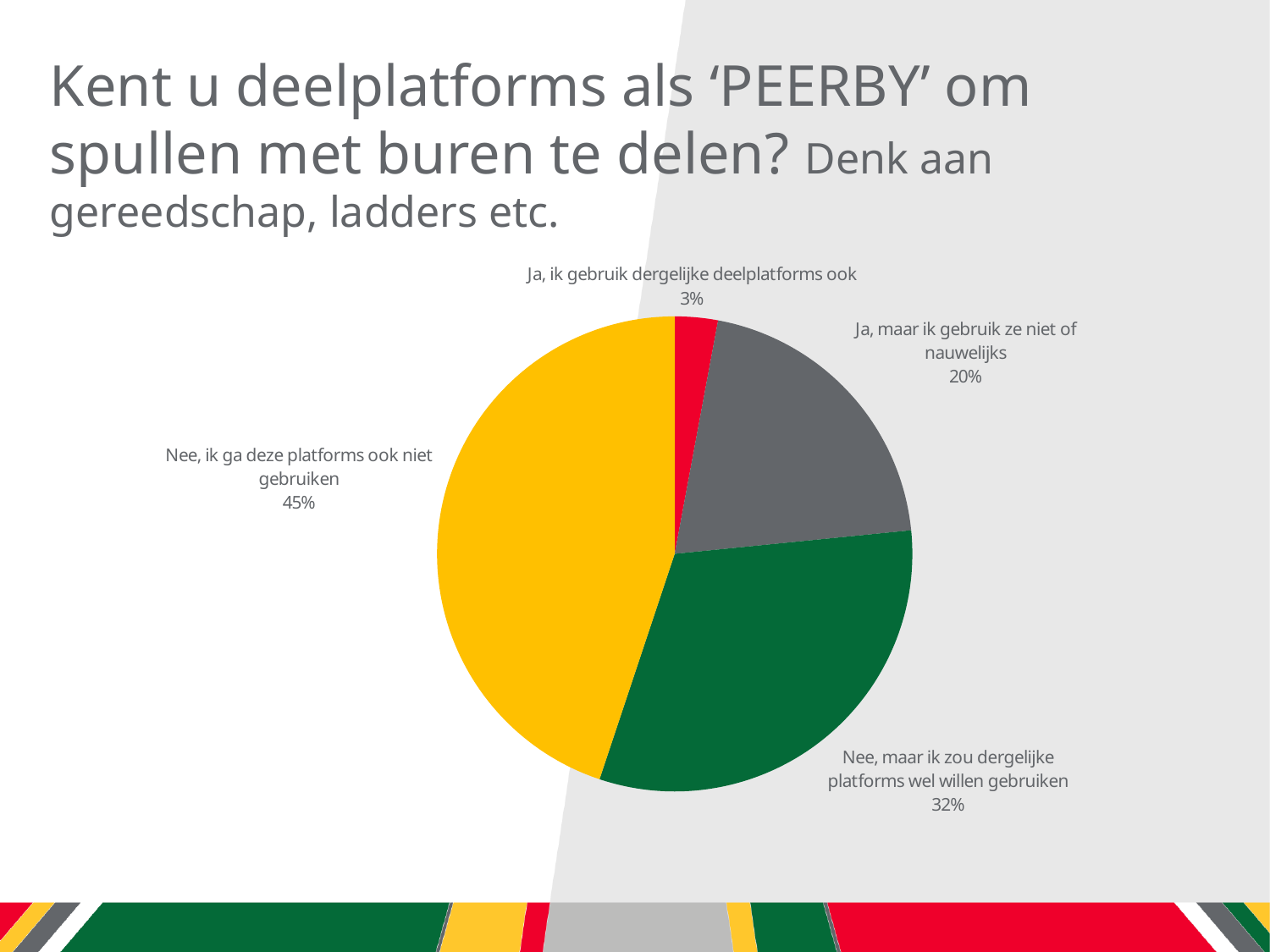
How many slices does the pie chart have? 4 What percentage of respondents answered 'Ja, maar ik gebruik ze niet of nauwelijks'? 20% What percentage of respondents answered 'Nee, ik ga deze platforms ook niet gebruiken'? 45% What is the combined share of the two 'Ja' answers? 23% Which is larger: the share for 'Ja, maar ik gebruik ze niet of nauwelijks' or the share for 'Nee, maar ik zou dergelijke platforms wel willen gebruiken'? Nee, maar ik zou dergelijke platforms wel willen gebruiken What is the difference in percentage points between 'Nee, ik ga deze platforms ook niet gebruiken' and 'Nee, maar ik zou dergelijke platforms wel willen gebruiken'? 13 percentage points What percentage of respondents answered 'Nee, maar ik zou dergelijke platforms wel willen gebruiken'? 32% Which answer category has the smallest share of the pie? Ja, ik gebruik dergelijke deelplatforms ook What colour is the slice for 'Nee, ik ga deze platforms ook niet gebruiken'? yellow Which answer category has the largest share of the pie? Nee, ik ga deze platforms ook niet gebruiken What percentage of respondents answered 'Ja, ik gebruik dergelijke deelplatforms ook'? 3% What kind of chart is shown on the slide? pie chart